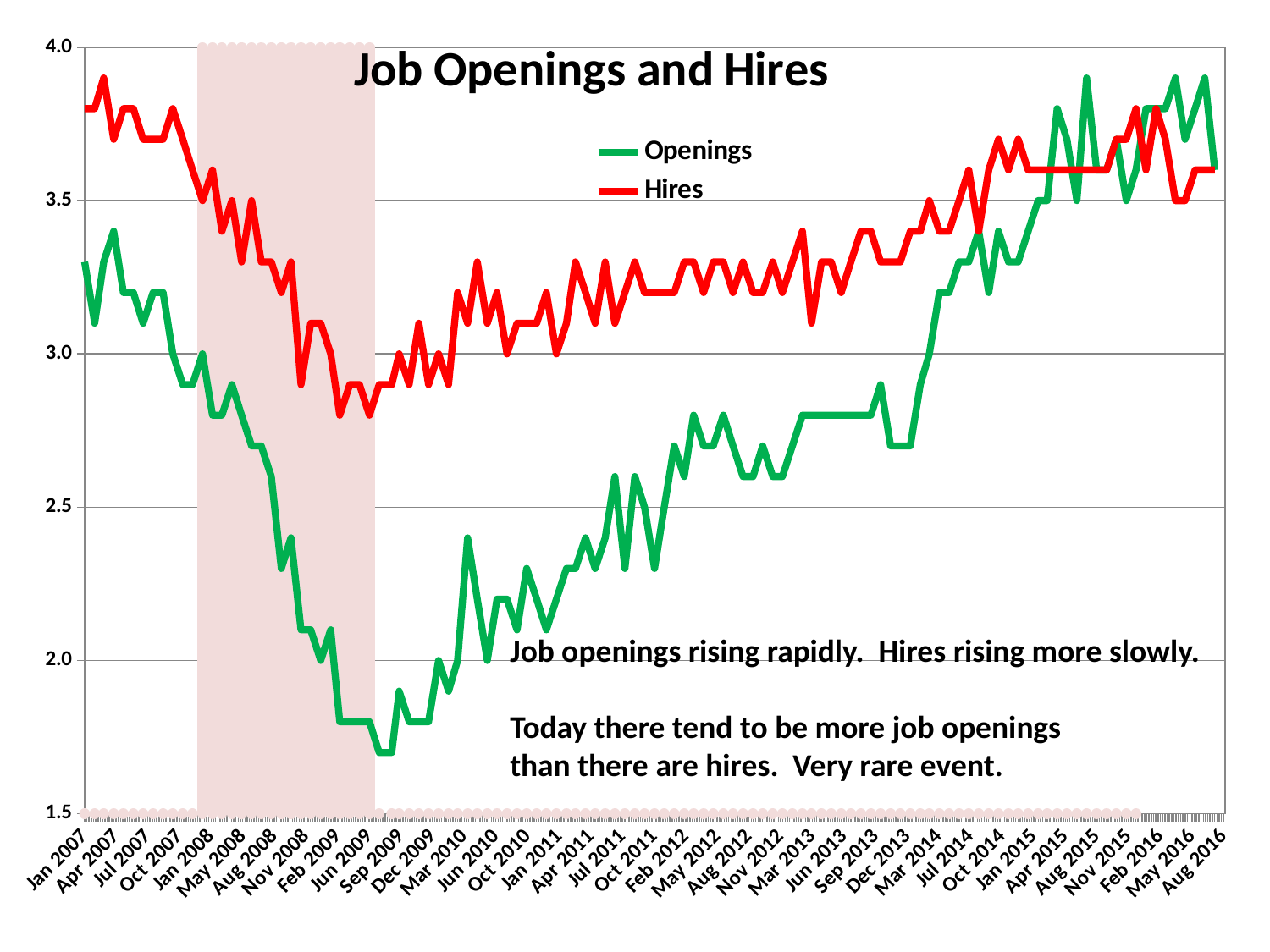
Is the value for Openings in Aug 2016 greater or less than 3.0? greater Is the value for Hires in Jun 2009 greater or less than 3.0? less In Jan 2007, which series has the higher value, Openings or Hires? Hires What kind of chart is shown on the slide? line chart Do the Openings values rise or fall from Jan 2007 to Jun 2009? fall Which colour is used for the Openings series? green Is the value for Hires in Jan 2007 greater or less than 3.5? greater Do the Openings values rise or fall from Sep 2009 to Aug 2016? rise What is the title of the chart? Job Openings and Hires How many series does the legend list? 2